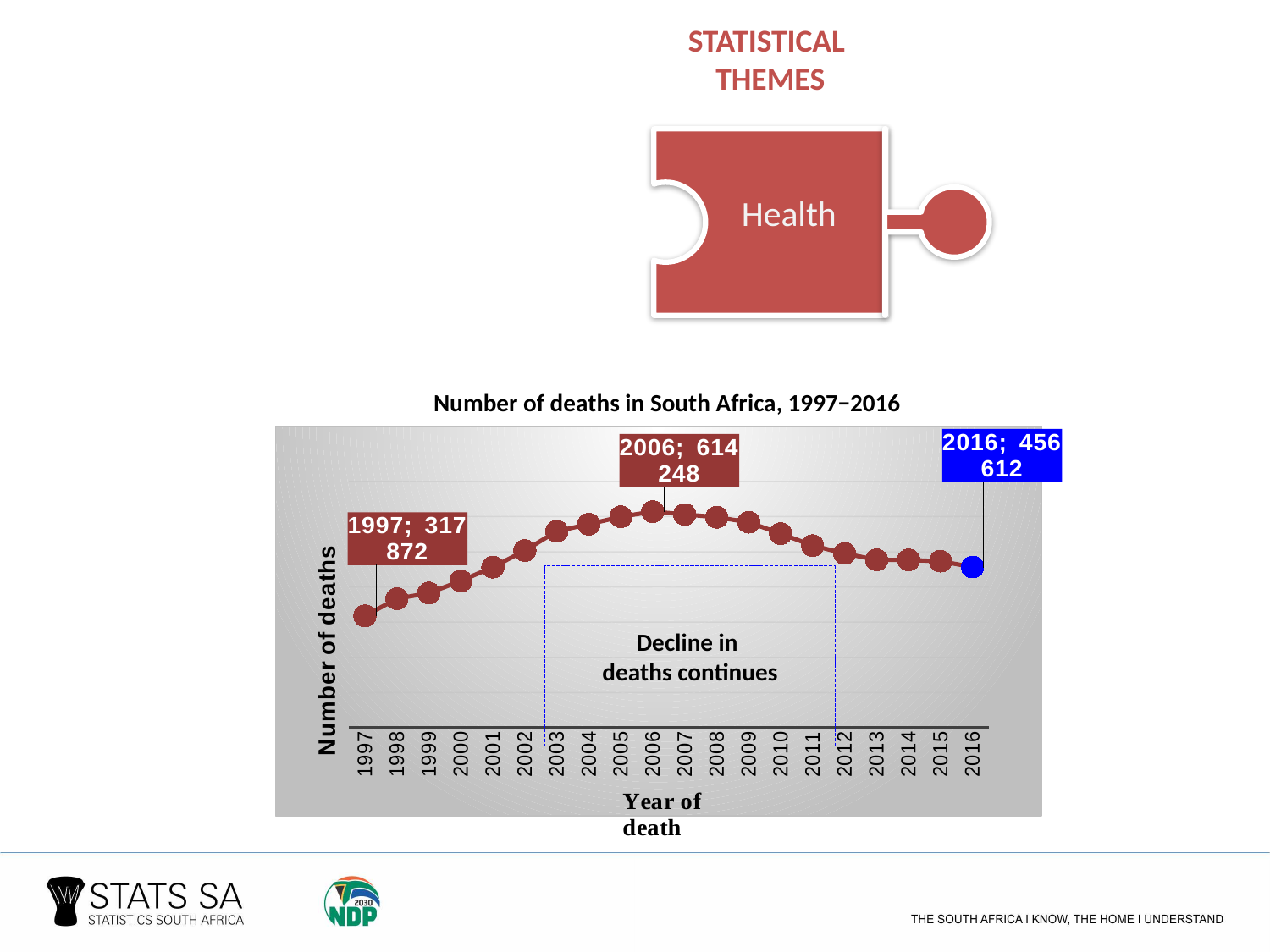
What is the title of the chart? Number of deaths in South Africa, 1997–2016 Which year had more deaths, 1997 or 2016? 2016 What kind of chart is shown on the slide? Line chart By how much did the number of deaths increase from 1997 to 2006? 296 376 What was the number of deaths in 2006? 614 248 In which year was the number of deaths highest? 2006 What was the number of deaths in 2016? 456 612 How many years are plotted on the x axis? 20 In which year was the number of deaths lowest? 1997 How does the number of deaths change from 2006 to 2016? It falls What was the number of deaths in 1997? 317 872 By how much did the number of deaths fall from 2006 to 2016? 157 636